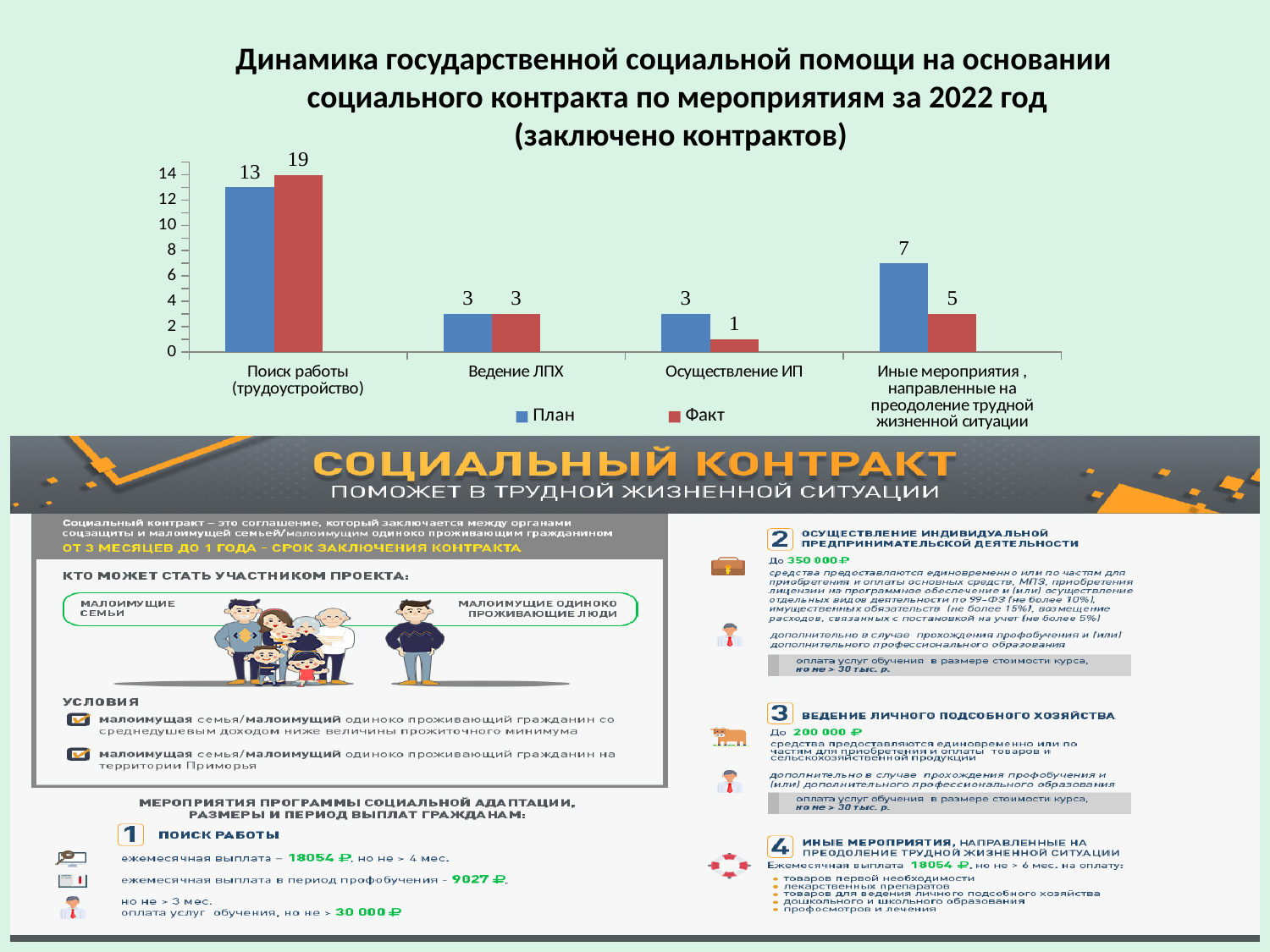
How many categories are shown on the x axis of the chart? 4 What are the two series named in the chart legend? План and Факт How many series does the chart legend list? 2 Which is larger for Иные мероприятия: the План value or the Факт value? План What is the Факт value for Поиск работы (трудоустройство)? 19 What is the План value for Поиск работы (трудоустройство)? 13 What is the difference between the Факт and План values for Поиск работы (трудоустройство)? 6 Which category has the highest Факт value? Поиск работы (трудоустройство) What type of chart is shown on the slide? bar chart Which category has the lowest Факт value? Осуществление ИП What is the План value for Иные мероприятия, направленные на преодоление трудной жизненной ситуации? 7 What is the Факт value for Осуществление ИП? 1